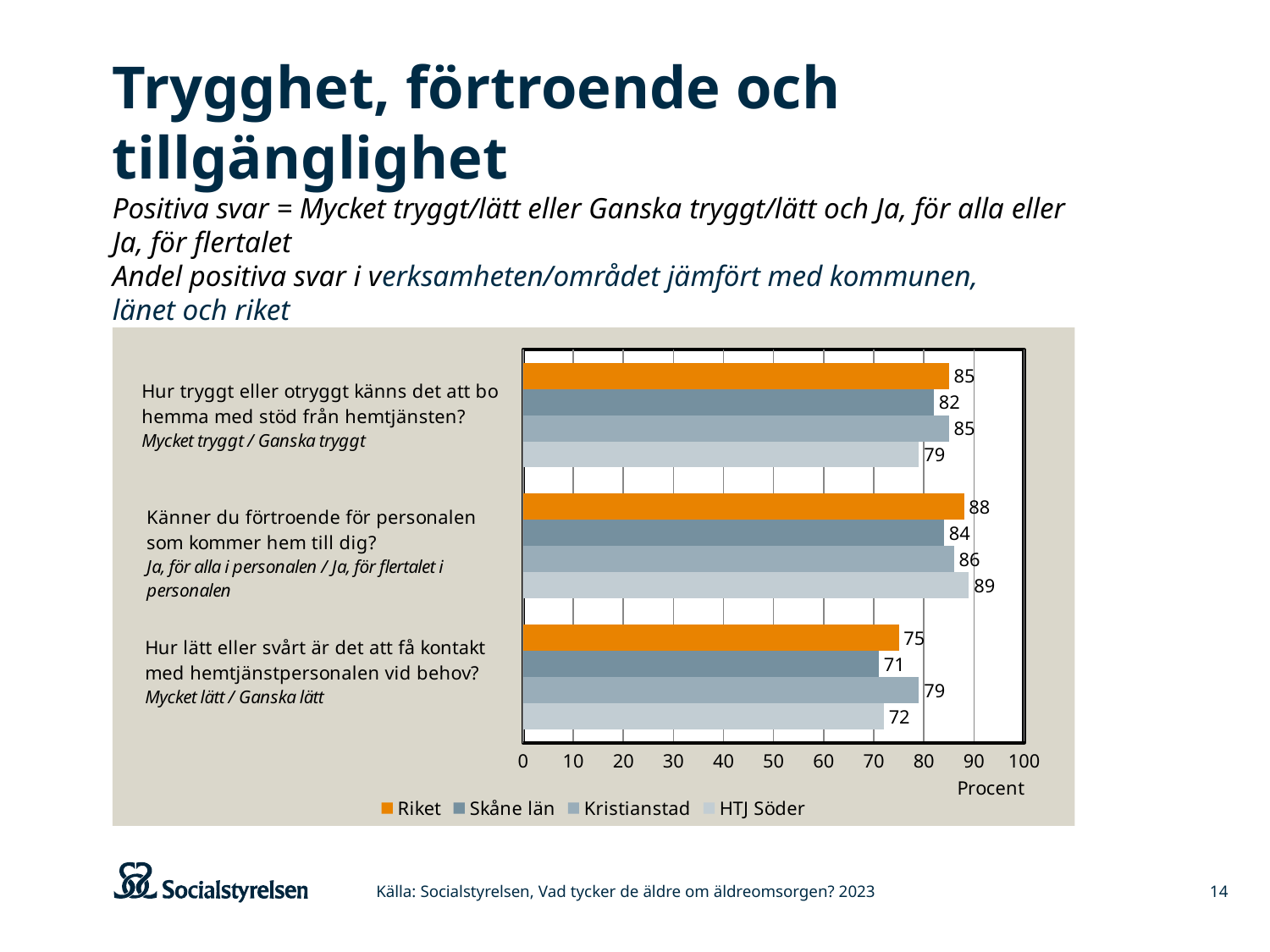
For the question "Hur tryggt eller otryggt känns det att bo hemma med stöd från hemtjänsten?", which is larger: Skåne län or HTJ Söder? Skåne län What is the value for HTJ Söder for the question "Hur tryggt eller otryggt känns det att bo hemma med stöd från hemtjänsten?"? 79 Is the value for Riket for the question "Hur lätt eller svårt är det att få kontakt med hemtjänstpersonalen vid behov?" greater or less than 80? less What is the value for Riket for the question "Känner du förtroende för personalen som kommer hem till dig?"? 88 How many series does the legend list? 4 Which series has the lowest value for the question "Hur lätt eller svårt är det att få kontakt med hemtjänstpersonalen vid behov?"? Skåne län How many question categories are plotted in the chart? 3 What type of chart is shown on the slide? Bar chart What is the value for Kristianstad for the question "Hur lätt eller svårt är det att få kontakt med hemtjänstpersonalen vid behov?"? 79 What is the difference between Kristianstad and HTJ Söder for the question "Hur lätt eller svårt är det att få kontakt med hemtjänstpersonalen vid behov?"? 7 Which series has the highest value for the question "Känner du förtroende för personalen som kommer hem till dig?"? HTJ Söder What label is shown on the x axis of the chart? Procent